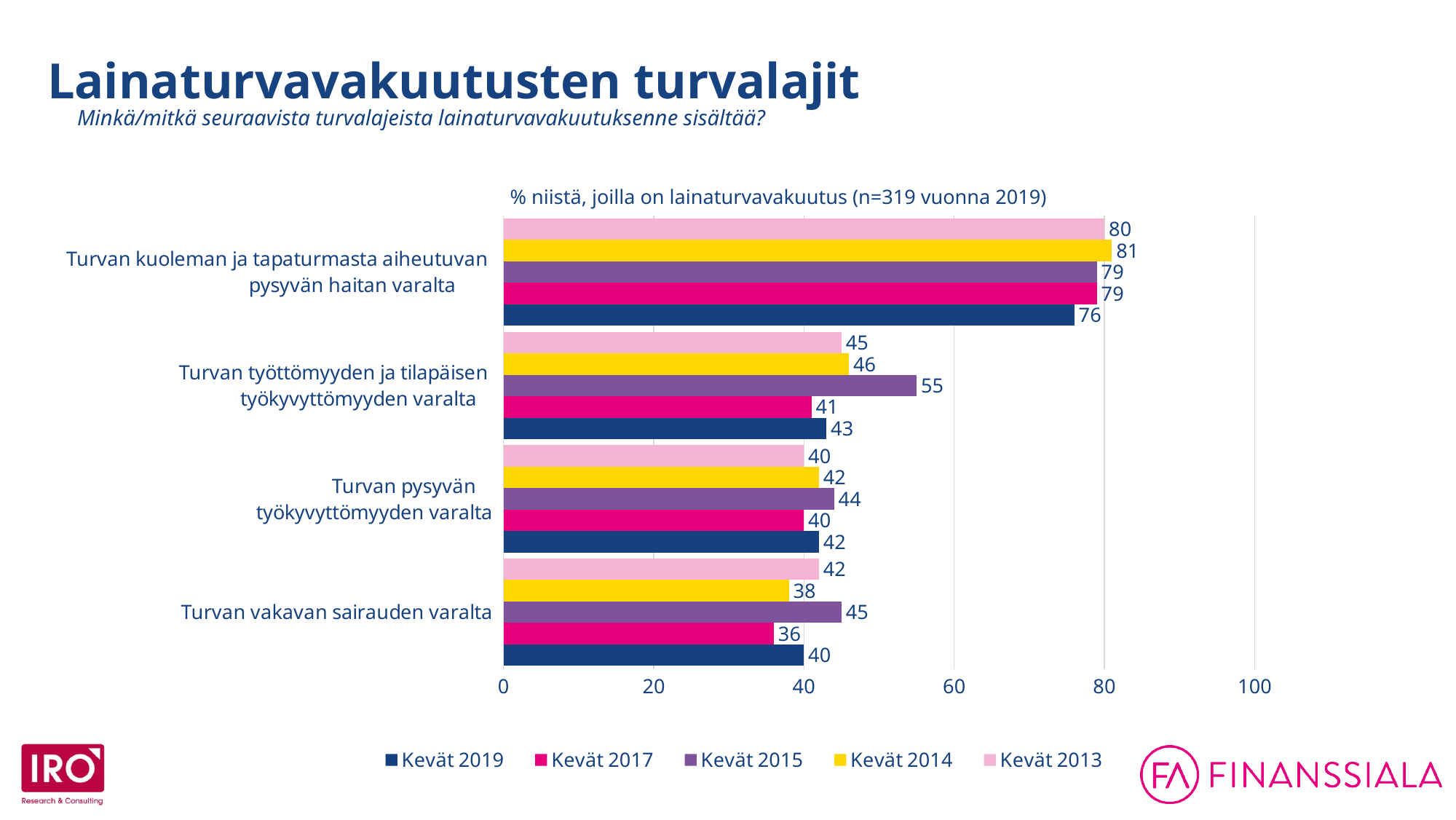
Which survey year has the lowest value for "Turvan vakavan sairauden varalta"? Kevät 2017 How many series does the legend list? 5 Is the Kevät 2014 value for "Turvan kuoleman ja tapaturmasta aiheutuvan pysyvän haitan varalta" greater or less than 80? greater What is the Kevät 2014 value for "Turvan pysyvän työkyvyttömyyden varalta"? 42 What is the Kevät 2015 value for "Turvan työttömyyden ja tilapäisen työkyvyttömyyden varalta"? 55 What is the difference between the Kevät 2015 and Kevät 2017 values for "Turvan työttömyyden ja tilapäisen työkyvyttömyyden varalta"? 14 Which category has the highest Kevät 2019 value? Turvan kuoleman ja tapaturmasta aiheutuvan pysyvän haitan varalta What kind of chart is shown on the slide? Bar chart For "Turvan vakavan sairauden varalta", which is larger: the Kevät 2013 value or the Kevät 2014 value? Kevät 2013 How many categories are shown on the chart? 4 What is the Kevät 2019 value for "Turvan kuoleman ja tapaturmasta aiheutuvan pysyvän haitan varalta"? 76 What is the Kevät 2017 value for "Turvan vakavan sairauden varalta"? 36